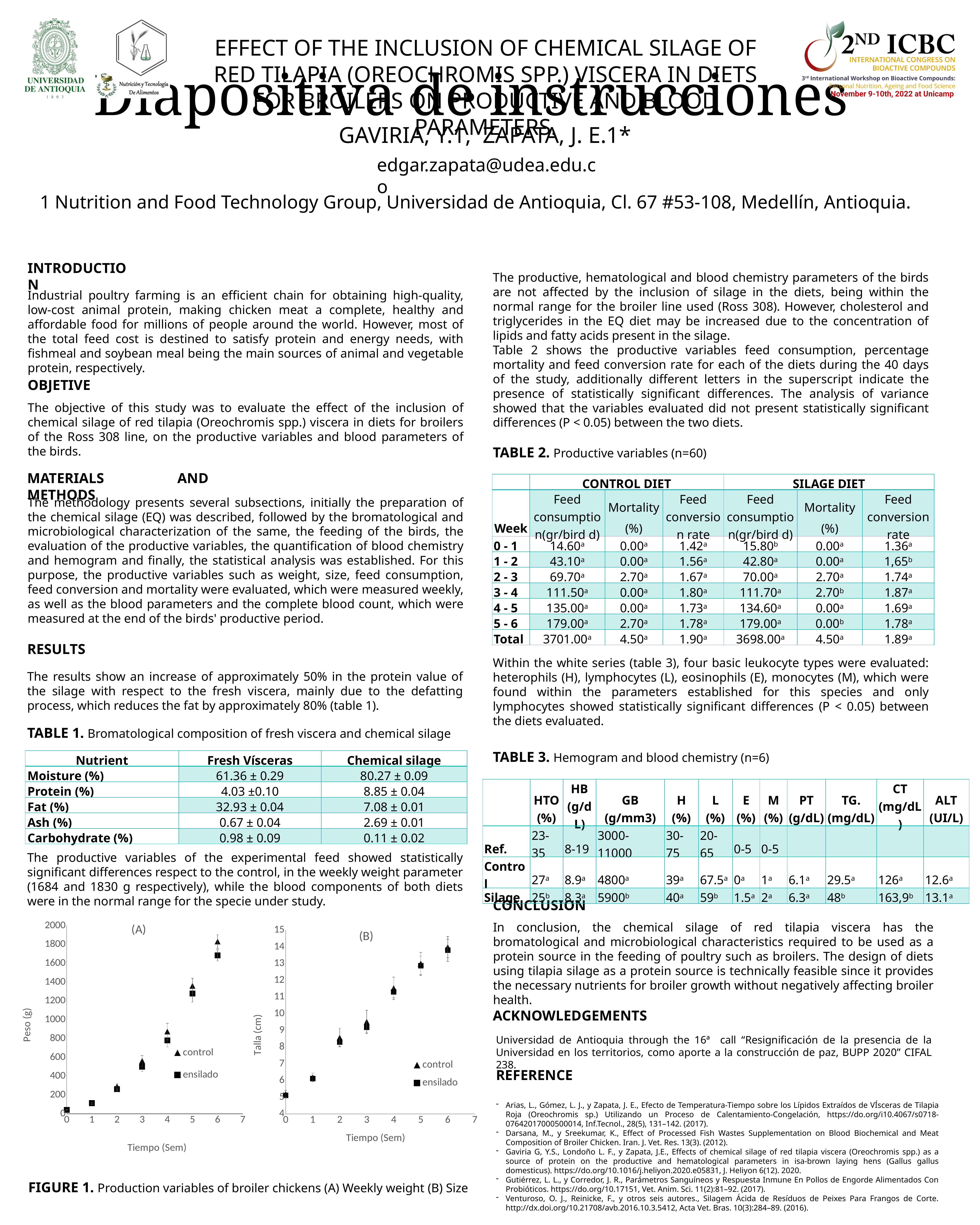
What are the two series named in the legend of chart (B)? control and ensilado In chart (A), at week 6, which series has the higher weight, control or ensilado? control In chart (A), at which week is the weight highest? week 6 In chart (B), is the value at week 0 greater or less than 6? less In chart (A), is the control value at week 6 greater or less than 1600? greater In chart (B), is the control value at week 6 greater or less than 12? greater What kind of chart is chart (A), Weekly weight? scatter chart What is the y-axis label of chart (B)? Talla (cm) In chart (A), do the weight values rise or fall as the weeks increase? rise How many series does the legend of chart (A) list? 2